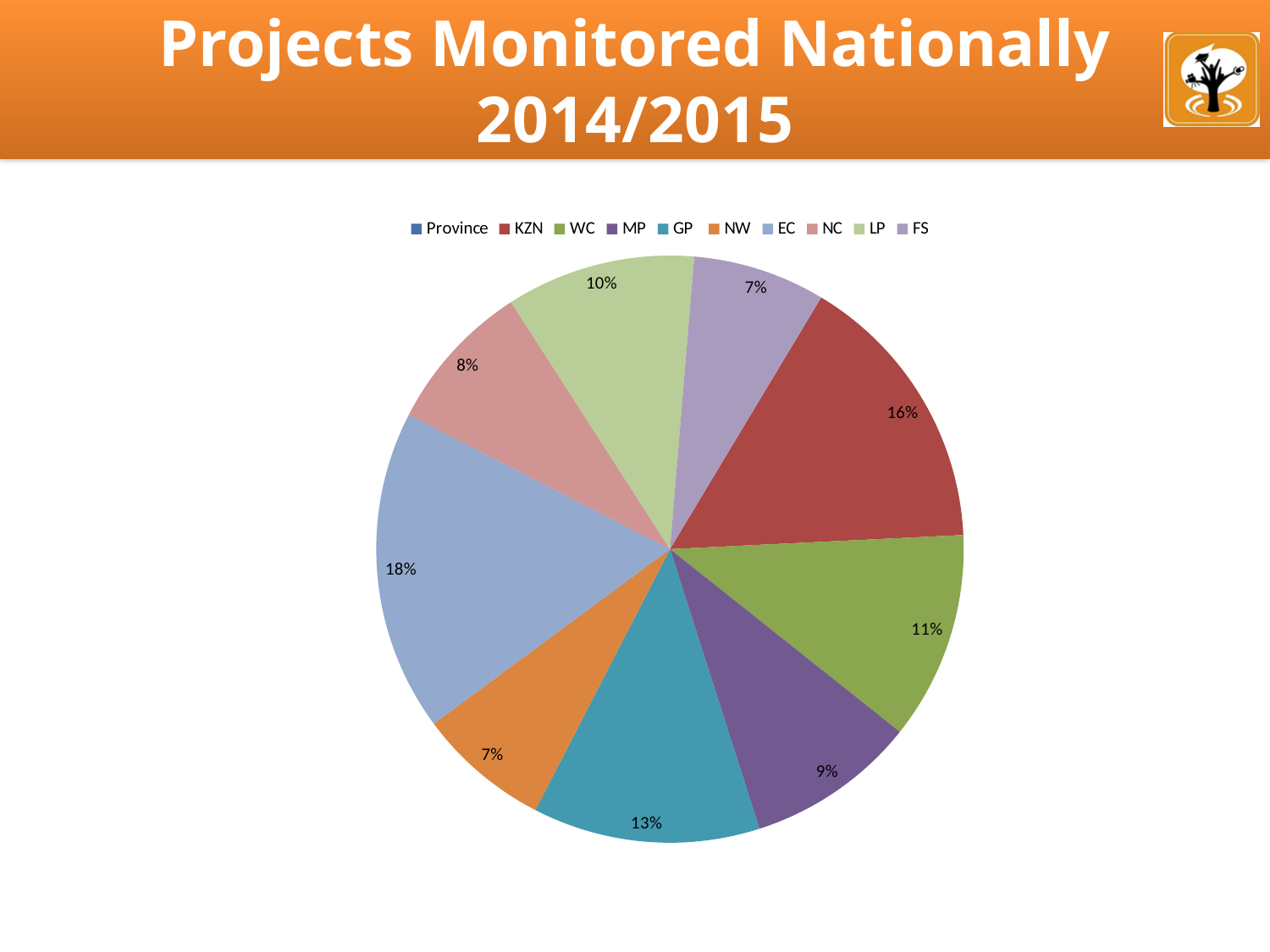
Which province has the largest slice of the pie? EC What is the value shown for LP? 10% Which is larger, the slice for KZN or the slice for WC? KZN What is the title of the slide containing the chart? Projects Monitored Nationally 2014/2015 What share of the pie does EC represent? 18% What is the value shown for GP? 13% How many entries does the legend list? 10 What is the value shown for NC? 8% What type of chart is shown on the slide? pie chart What share of the pie does KZN represent? 16% What is the difference between the EC share and the KZN share? 2% What is the value shown for WC? 11%